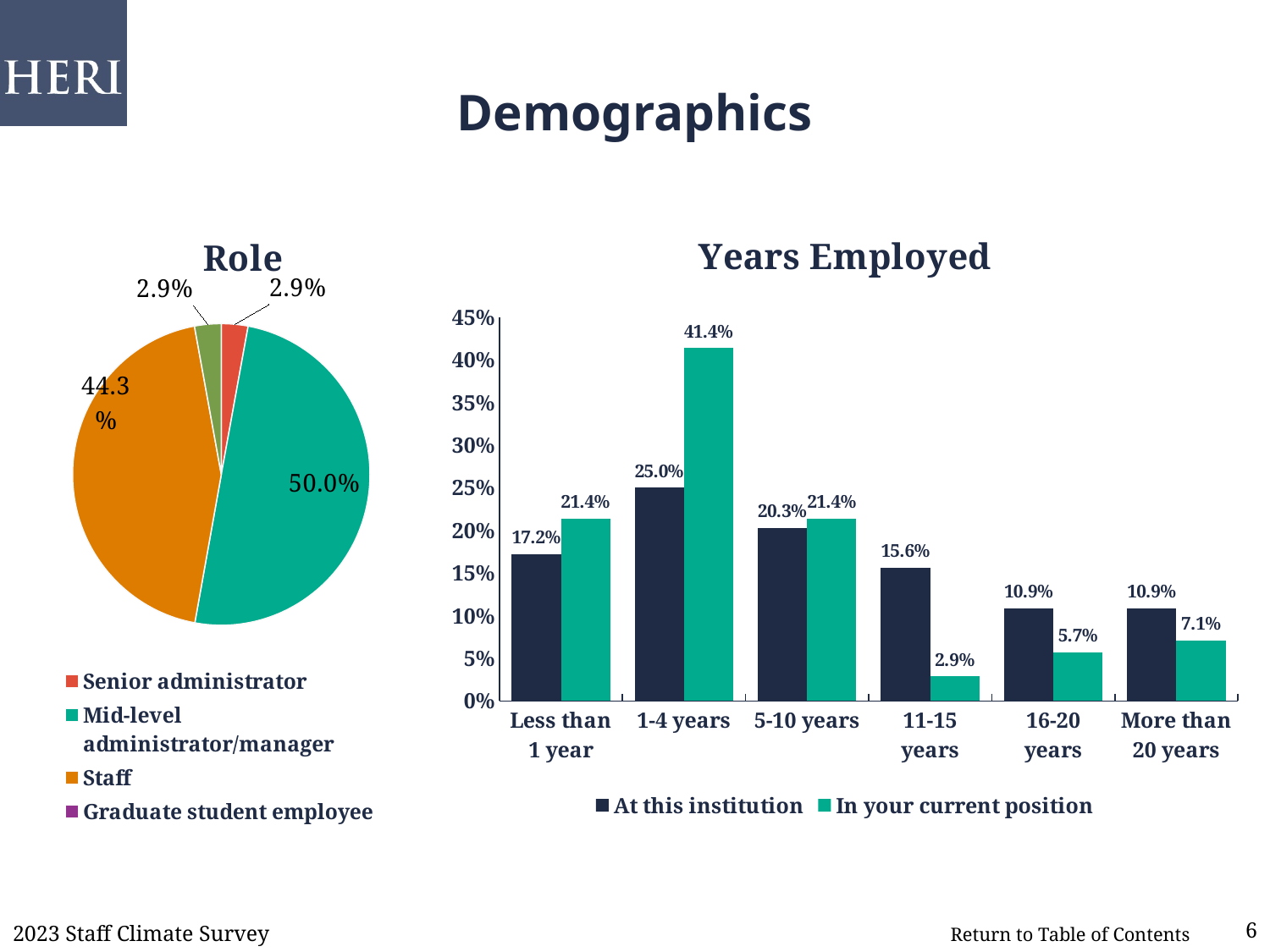
How many series does the legend of the Years Employed chart list? 2 In the Role pie chart, what share is Staff? 44.3% In the Years Employed chart, what is the difference between In your current position and At this institution for 1-4 years? 16.4 percentage points In the Years Employed chart, which category has the lowest value for In your current position? 11-15 years In the Role pie chart, what share is Mid-level administrator/manager? 50.0% In the Years Employed chart, for 16-20 years, which series has the larger value? At this institution In the Years Employed chart, what is the value for 1-4 years in the In your current position series? 41.4% In the Role pie chart, which role has the largest slice? Mid-level administrator/manager In the Years Employed chart, what is the value for 11-15 years in the At this institution series? 15.6% What kind of chart is the Years Employed chart? Bar chart In the Years Employed chart, which category has the highest value for In your current position? 1-4 years How many roles does the Role pie chart's legend list? 4